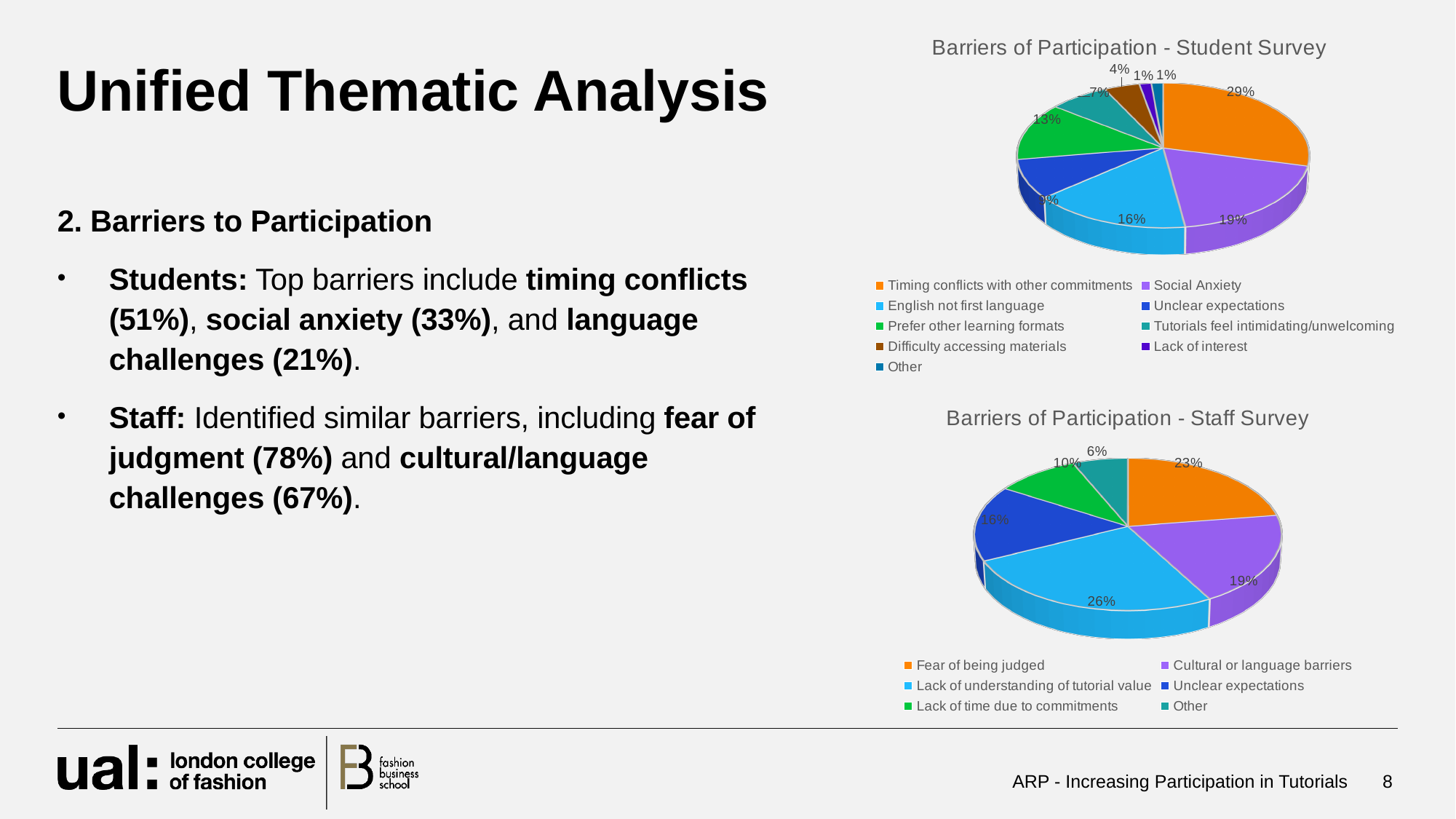
In the 'Barriers of Participation - Student Survey' chart, what percentage is shown for 'Prefer other learning formats'? 13% In the 'Barriers of Participation - Student Survey' chart, what percentage is shown for 'Timing conflicts with other commitments'? 29% What type of chart is the 'Barriers of Participation - Staff Survey' chart? Pie chart In the 'Barriers of Participation - Student Survey' chart, which category has the largest slice? Timing conflicts with other commitments In the 'Barriers of Participation - Staff Survey' chart, which is larger: 'Unclear expectations' or 'Lack of time due to commitments'? Unclear expectations In the 'Barriers of Participation - Staff Survey' chart, which category has the smallest slice? Other In the 'Barriers of Participation - Student Survey' chart, what is the difference between the 'Timing conflicts with other commitments' slice and the 'English not first language' slice? 13% In the 'Barriers of Participation - Student Survey' chart, what percentage is shown for 'Social Anxiety'? 19% In the 'Barriers of Participation - Staff Survey' chart, what percentage is shown for 'Lack of understanding of tutorial value'? 26% In the 'Barriers of Participation - Student Survey' chart, how many categories does the legend list? 9 In the 'Barriers of Participation - Staff Survey' chart, what percentage is shown for 'Fear of being judged'? 23% In the 'Barriers of Participation - Staff Survey' chart, how many categories does the legend list? 6